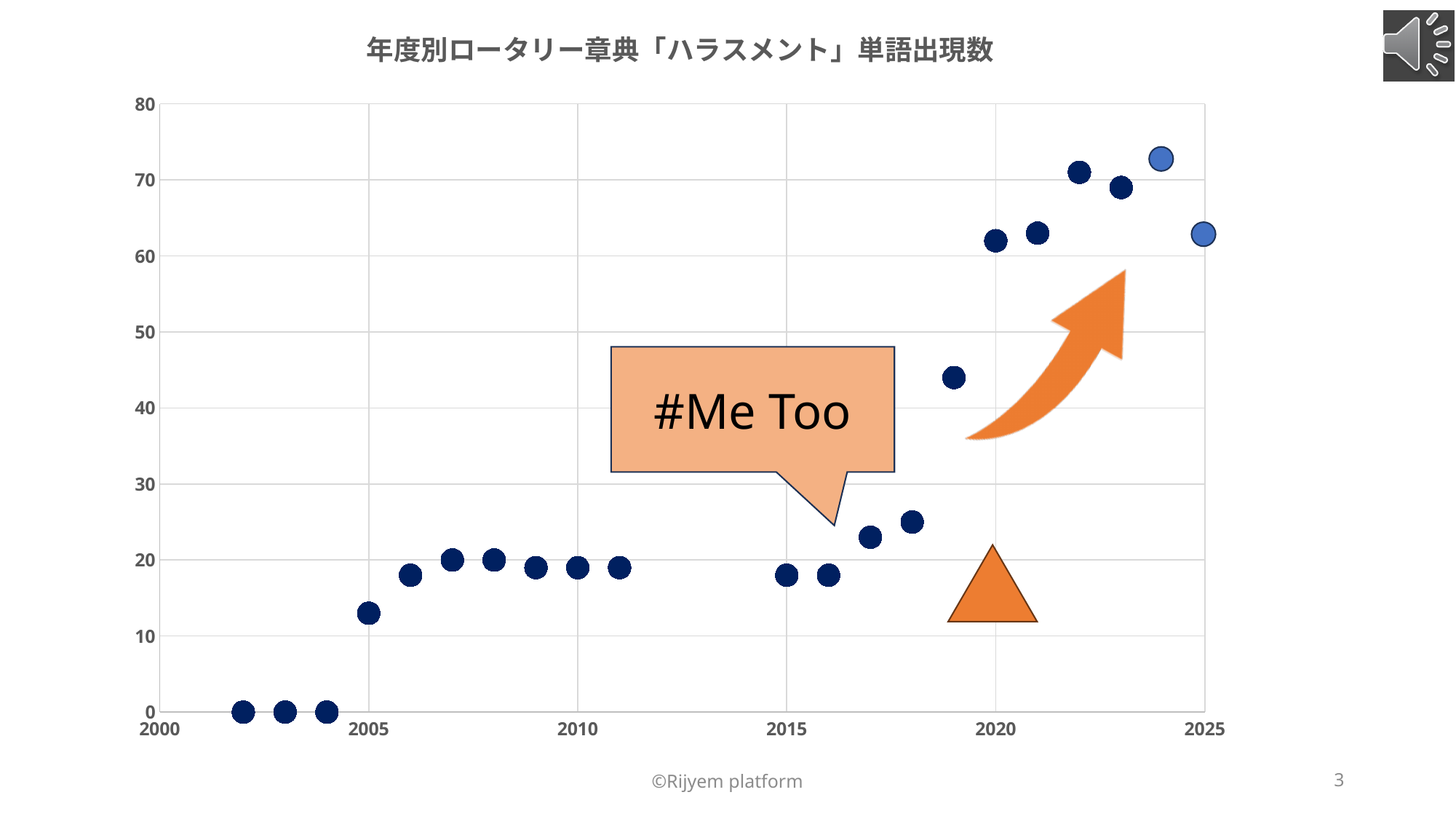
Is the value for 2020 greater or less than 60? greater What is the value plotted for 2003? 0 What kind of chart is shown on the slide? scatter chart What is the value plotted for 2007? 20 Is the value for 2015 greater or less than 20? less Do the values generally rise or fall from 2000 to 2025? rise Is the value for 2019 greater or less than 40? greater What is the title of the chart? 年度別ロータリー章典「ハラスメント」単語出現数 Which year has the larger value, 2018 or 2019? 2019 Which year has the larger value, 2010 or 2021? 2021 What text is written in the callout box on the chart? #Me Too